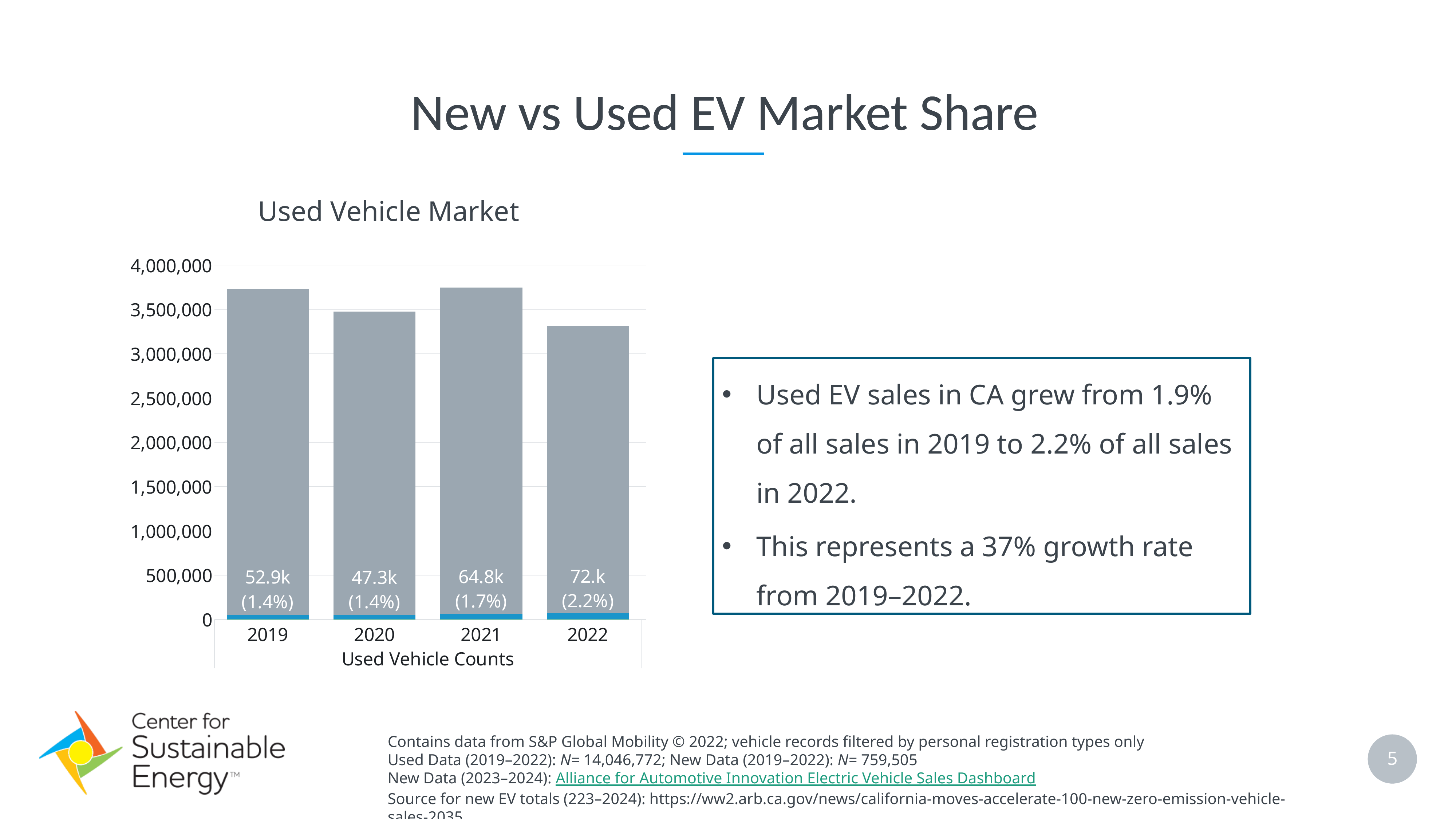
What is the used EV count label shown for 2022? 72.k (2.2%) What is the difference between the used EV count labels for 2021 and 2020? 17.5k Is the total used vehicle count bar for 2022 greater or less than 3,500,000? less Which year has the highest used EV count label? 2022 Which year has a larger used EV count label, 2019 or 2021? 2021 How many years are shown on the x axis of the chart? 4 What is the used EV count label shown for 2019? 52.9k (1.4%) What percentage share is shown for used EVs in 2021? 1.7% Is the total used vehicle count bar for 2019 greater or less than 3,500,000? greater What kind of chart is used to show the Used Vehicle Market? bar chart Which year has the lowest used EV count label? 2020 Which year has the lowest total used vehicle count bar? 2022